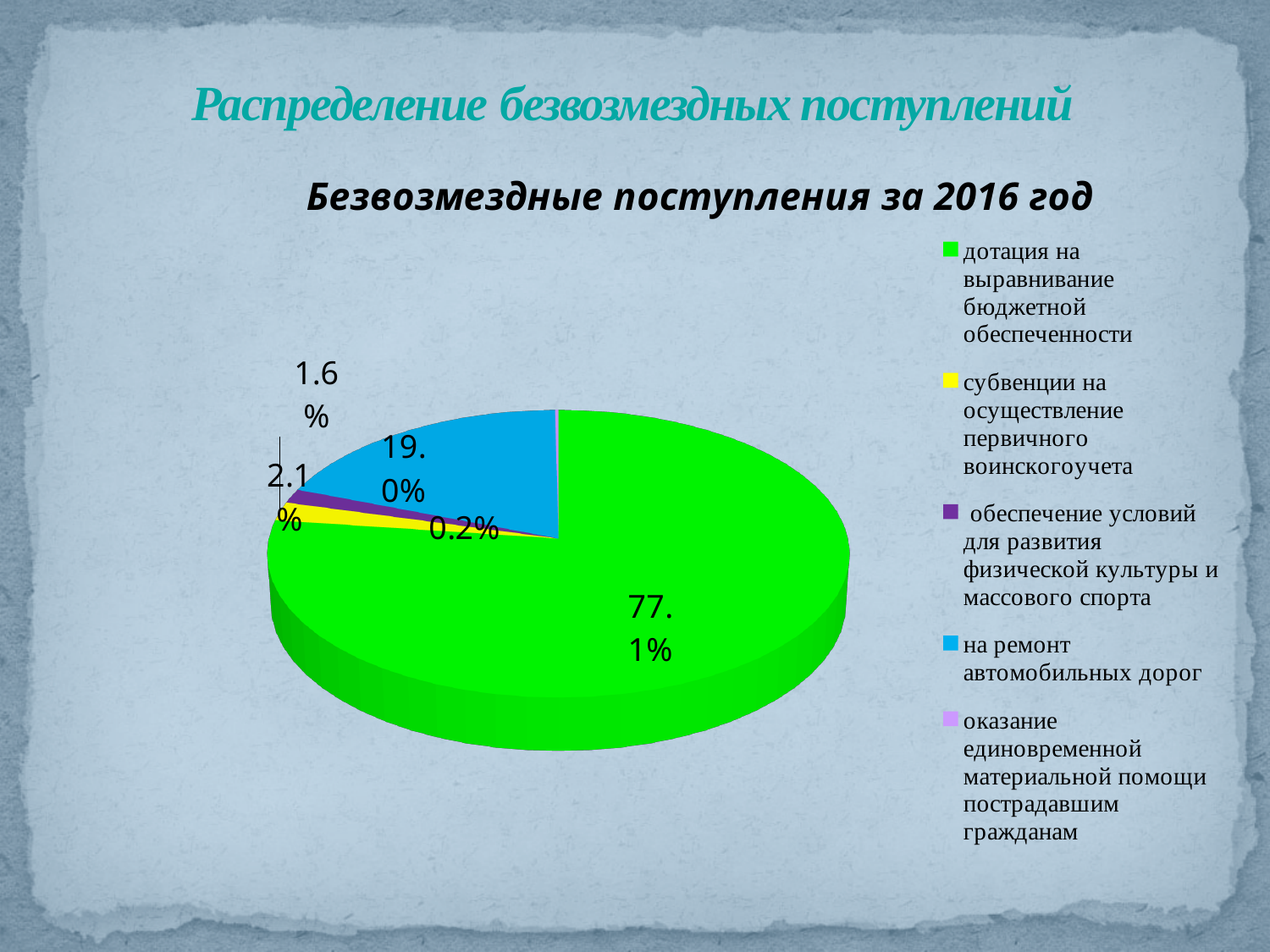
What value is shown for 'оказание единовременной материальной помощи пострадавшим гражданам'? 0.2% What value is shown for 'субвенции на осуществление первичного воинского учета'? 2.1% Which category has the largest slice of the pie? дотация на выравнивание бюджетной обеспеченности What value is shown for 'обеспечение условий для развития физической культуры и массового спорта'? 1.6% Which is larger: the share for 'субвенции на осуществление первичного воинского учета' or the share for 'обеспечение условий для развития физической культуры и массового спорта'? субвенции на осуществление первичного воинского учета What is the difference between the share for 'дотация на выравнивание бюджетной обеспеченности' and the share for 'на ремонт автомобильных дорог'? 58.1% How many slices does the pie chart have? 5 What share of the pie does the slice for 'на ремонт автомобильных дорог' represent? 19.0% Which category has the smallest slice of the pie? оказание единовременной материальной помощи пострадавшим гражданам What is the title of the chart? Безвозмездные поступления за 2016 год What share of the pie does the slice for 'дотация на выравнивание бюджетной обеспеченности' represent? 77.1% What kind of chart is shown on the slide? pie chart